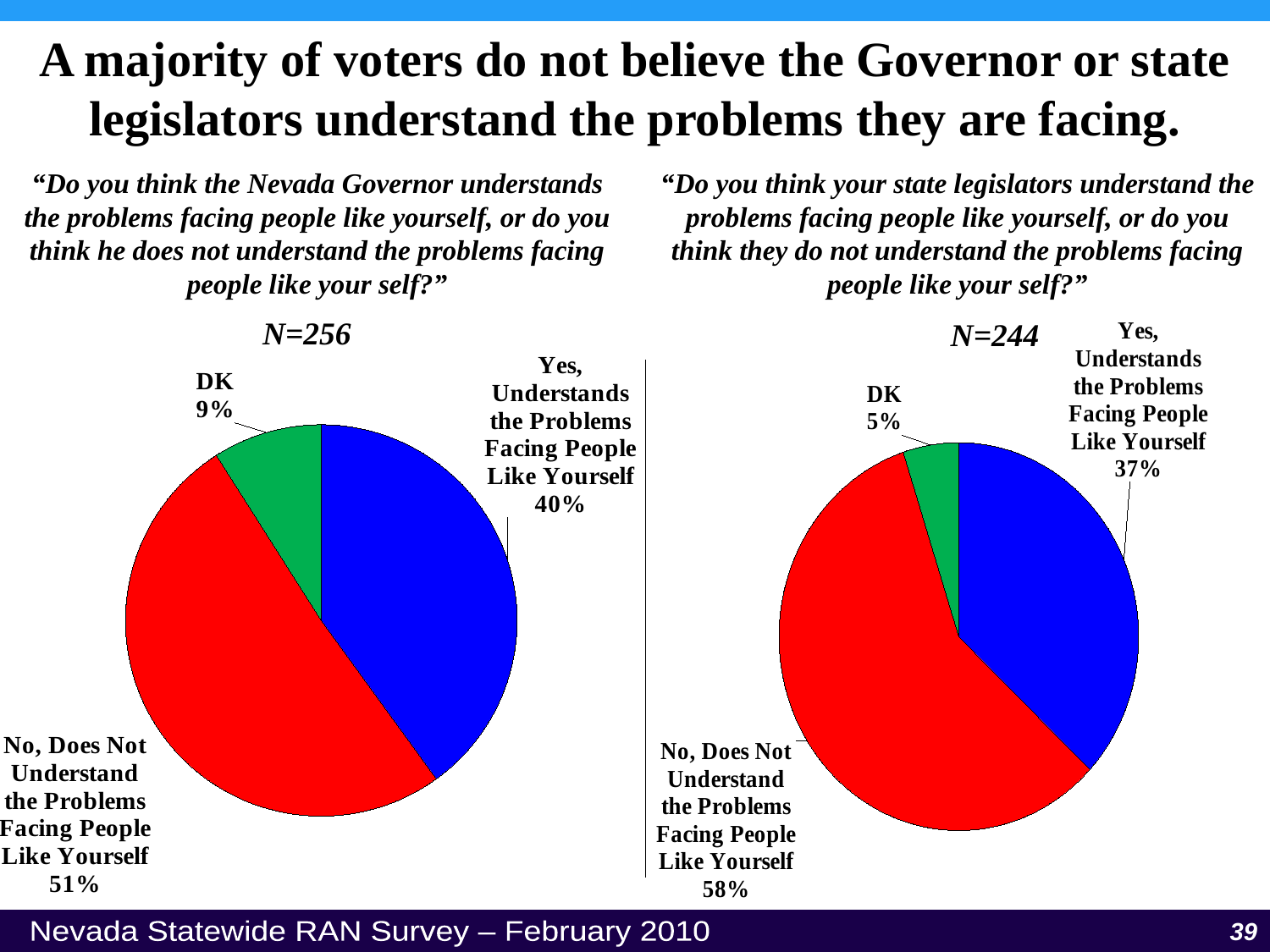
In the right pie chart (state legislators, N=244), what percentage of voters answered 'DK'? 5% Which is larger: the 'No, Does Not Understand' share in the left pie chart (Governor) or the 'No, Does Not Understand' share in the right pie chart (state legislators)? The right pie chart (state legislators), 58% In the left pie chart (Nevada Governor, N=256), which response has the smallest share? DK In the left pie chart (Nevada Governor, N=256), what percentage of voters answered 'DK'? 9% How many slices does the right pie chart (state legislators, N=244) have? 3 In the right pie chart (state legislators, N=244), what percentage of voters said 'Yes, Understands the Problems Facing People Like Yourself'? 37% What type of chart is used on the left side of the slide for the Nevada Governor question? Pie chart What is the sample size (N) shown for the right pie chart about state legislators? N=244 In the left pie chart (Nevada Governor, N=256), what colour is the 'DK' slice? Green In the right pie chart (state legislators, N=244), which response has the largest share? No, Does Not Understand the Problems Facing People Like Yourself In the left pie chart (Nevada Governor, N=256), what percentage of voters said 'No, Does Not Understand the Problems Facing People Like Yourself'? 51% In the left pie chart (Nevada Governor, N=256), what is the difference in percentage points between the 'No, Does Not Understand' share and the 'Yes, Understands' share? 11